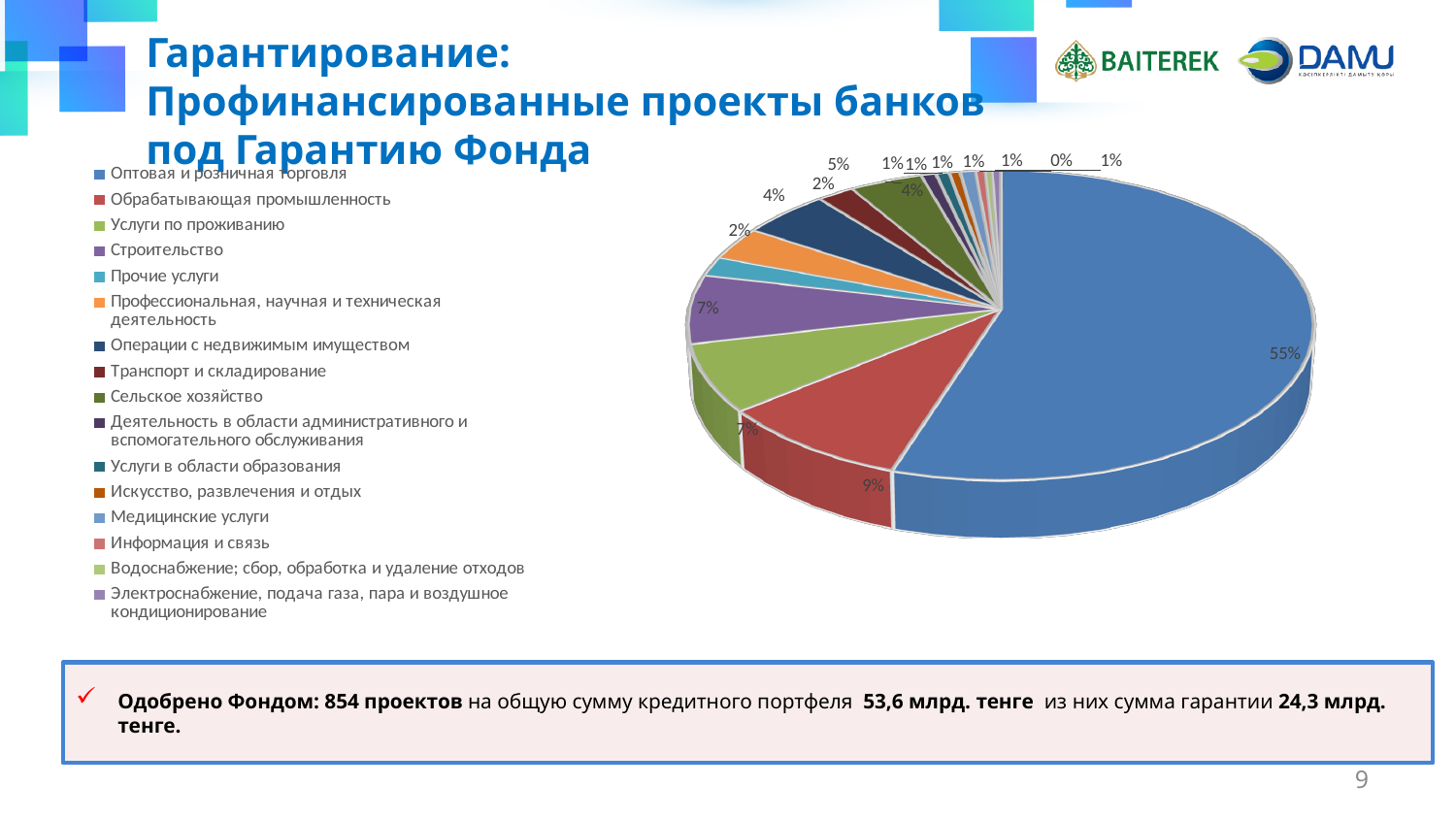
What is the difference in percentage points between Оптовая и розничная торговля and Обрабатывающая промышленность? 46 percentage points Which category has the largest share of the pie? Оптовая и розничная торговля What is the value shown for Обрабатывающая промышленность? 9% Which is larger, the share for Операции с недвижимым имуществом or the share for Прочие услуги? Операции с недвижимым имуществом What is the value shown for Операции с недвижимым имуществом? 5% Which is larger, the share for Обрабатывающая промышленность or the share for Услуги по проживанию? Обрабатывающая промышленность What is the value shown for Строительство? 7% What share of the pie does Оптовая и розничная торговля have? 55% How many categories does the legend list? 16 What is the value shown for Профессиональная, научная и техническая деятельность? 4% What kind of chart is shown on the slide? Pie chart What colour is the largest slice of the pie? Blue